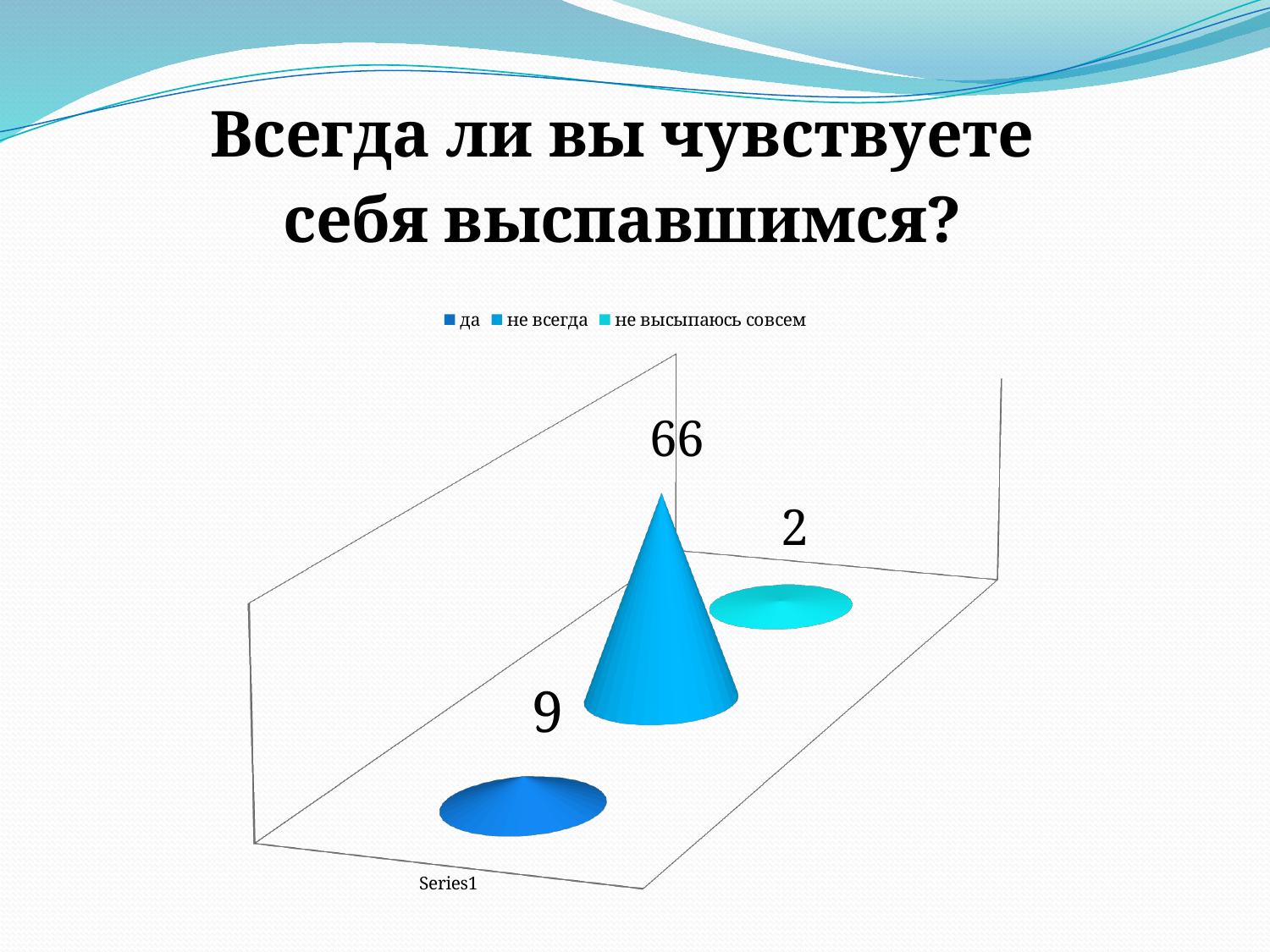
What is the difference between the values for "не всегда" and "да"? 57 Which legend entry has the highest value? не всегда How many series does the legend list? 3 What is the value for "не всегда"? 66 What is the value for "не высыпаюсь совсем"? 2 What label is shown on the category axis of the chart? Series1 What is the difference between the values for "да" and "не высыпаюсь совсем"? 7 What is the total of the three values shown on the chart? 77 Which legend entry has the lowest value? не высыпаюсь совсем Which is larger, the value for "да" or the value for "не высыпаюсь совсем"? да What is the value for "да"? 9 What is the title of the slide above the chart? Всегда ли вы чувствуете себя выспавшимся?